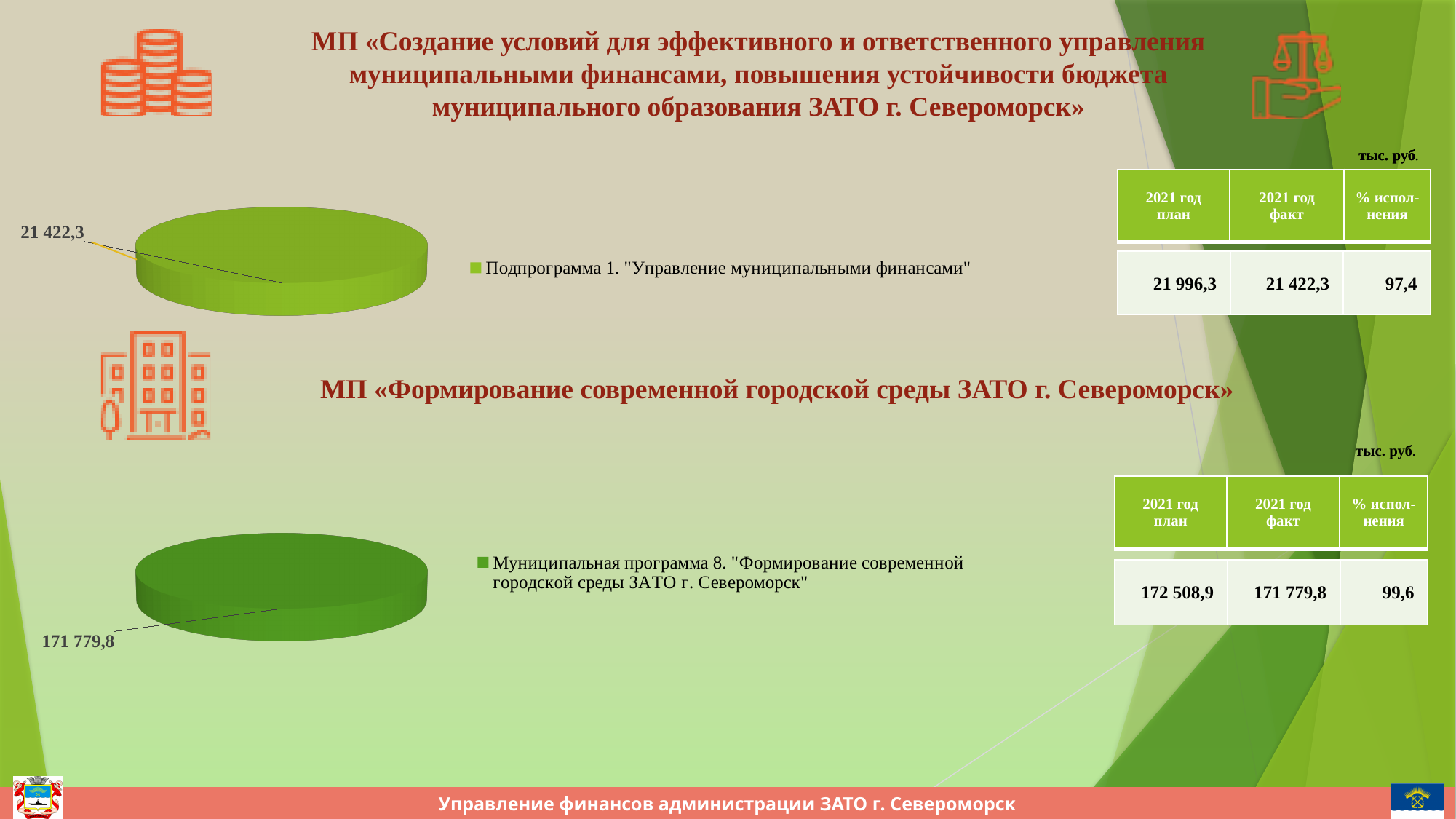
How many slices does the bottom pie chart have? 1 Which is larger: the value on the top pie chart (21 422,3) or the value on the bottom pie chart (171 779,8)? The bottom pie chart (171 779,8) What kind of chart is the top chart on the slide? Pie chart How many entries does the legend of the bottom pie chart list? 1 On the top pie chart, what value is shown for Подпрограмма 1. "Управление муниципальными финансами"? 21 422,3 What kind of chart is the bottom chart on the slide? Pie chart What is the legend entry of the top pie chart? Подпрограмма 1. "Управление муниципальными финансами" How many slices does the top pie chart have? 1 On the top pie chart, what share of the pie does the slice for Подпрограмма 1 represent? 100% On the bottom pie chart, what value is shown for Муниципальная программа 8. "Формирование современной городской среды ЗАТО г. Североморск"? 171 779,8 What colour is the slice of the bottom pie chart? Green How many entries does the legend of the top pie chart list? 1